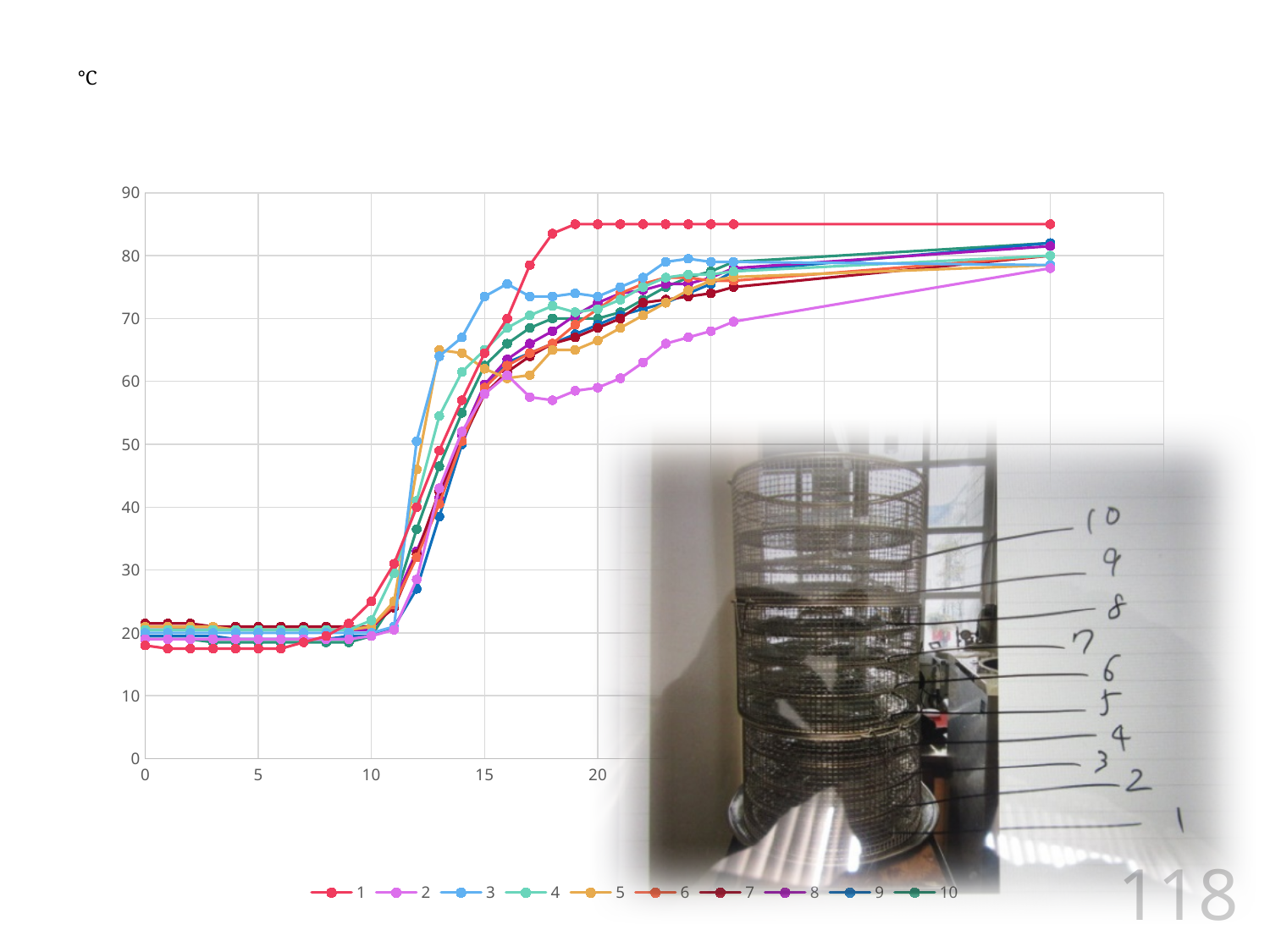
Is the value of series 1 at x = 20 greater or less than 80? greater How many series does the legend list? 10 What is the highest value labelled on the vertical axis? 90 Is the value of series 1 at x = 0 greater or less than 20? less Is the value of series 3 at x = 15 greater or less than 70? greater What unit is shown for the vertical axis? °C Which series has the highest value at x = 20? 1 At x = 16, which is larger: series 3 or series 2? series 3 Do the values of series 1 rise or fall between x = 10 and x = 20? rise What kind of chart is shown on the slide? line chart Which series has the lowest value at x = 20? 2